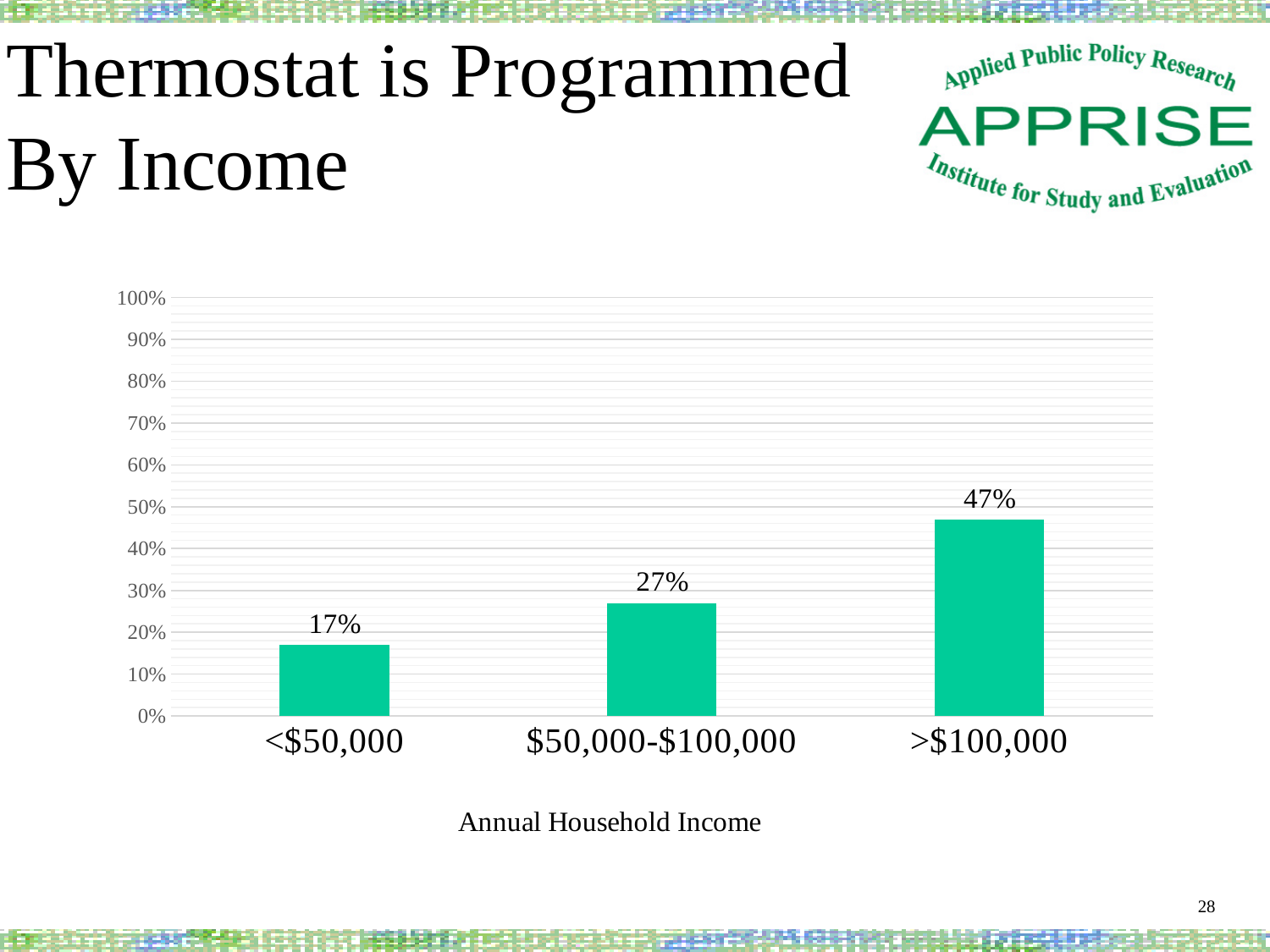
What is the value for the $50,000-$100,000 income group? 27% What is the value for the >$100,000 income group? 47% Do the values rise or fall as income increases along the x axis? rise Which is larger, the value for $50,000-$100,000 or the value for >$100,000? >$100,000 What kind of chart is shown on the slide? bar chart What is the difference between the >$100,000 group and the <$50,000 group? 30% Is the value for >$100,000 greater or less than 50%? less What percentage of households with income <$50,000 have a programmed thermostat? 17% Which income group has the lowest share of programmed thermostats? <$50,000 How many income categories are shown on the chart? 3 Which income group has the highest share of programmed thermostats? >$100,000 What is the difference between the $50,000-$100,000 group and the <$50,000 group? 10%